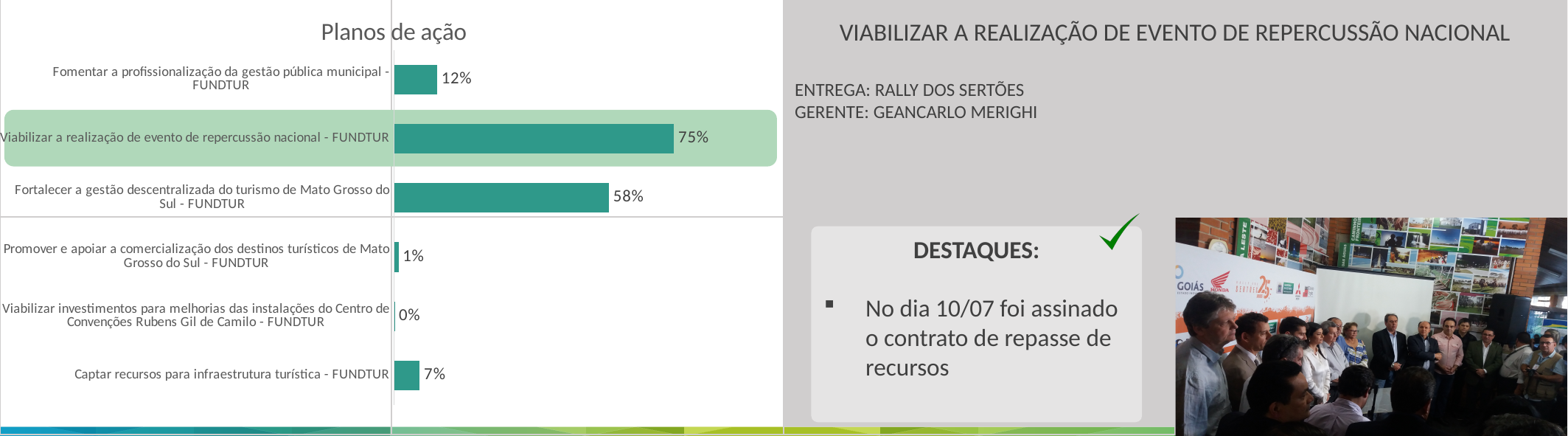
What is the title of the chart on the slide? Planos de ação What is the value for "Viabilizar investimentos para melhorias das instalações do Centro de Convenções Rubens Gil de Camilo - FUNDTUR"? 0% What is the value for "Captar recursos para infraestrutura turística - FUNDTUR"? 7% Which category's row is highlighted with a green background in the chart? Viabilizar a realização de evento de repercussão nacional - FUNDTUR What type of chart is shown on the slide? bar chart How many categories does the chart show? 6 Which category has the highest value in the chart? Viabilizar a realização de evento de repercussão nacional - FUNDTUR Which category has the lowest value in the chart? Viabilizar investimentos para melhorias das instalações do Centro de Convenções Rubens Gil de Camilo - FUNDTUR What is the value for "Fortalecer a gestão descentralizada do turismo de Mato Grosso do Sul - FUNDTUR"? 58% Which is larger: the value for "Fomentar a profissionalização da gestão pública municipal - FUNDTUR" or the value for "Captar recursos para infraestrutura turística - FUNDTUR"? Fomentar a profissionalização da gestão pública municipal - FUNDTUR What is the difference between the values for "Viabilizar a realização de evento de repercussão nacional - FUNDTUR" and "Fortalecer a gestão descentralizada do turismo de Mato Grosso do Sul - FUNDTUR"? 17% What is the value for "Viabilizar a realização de evento de repercussão nacional - FUNDTUR"? 75%